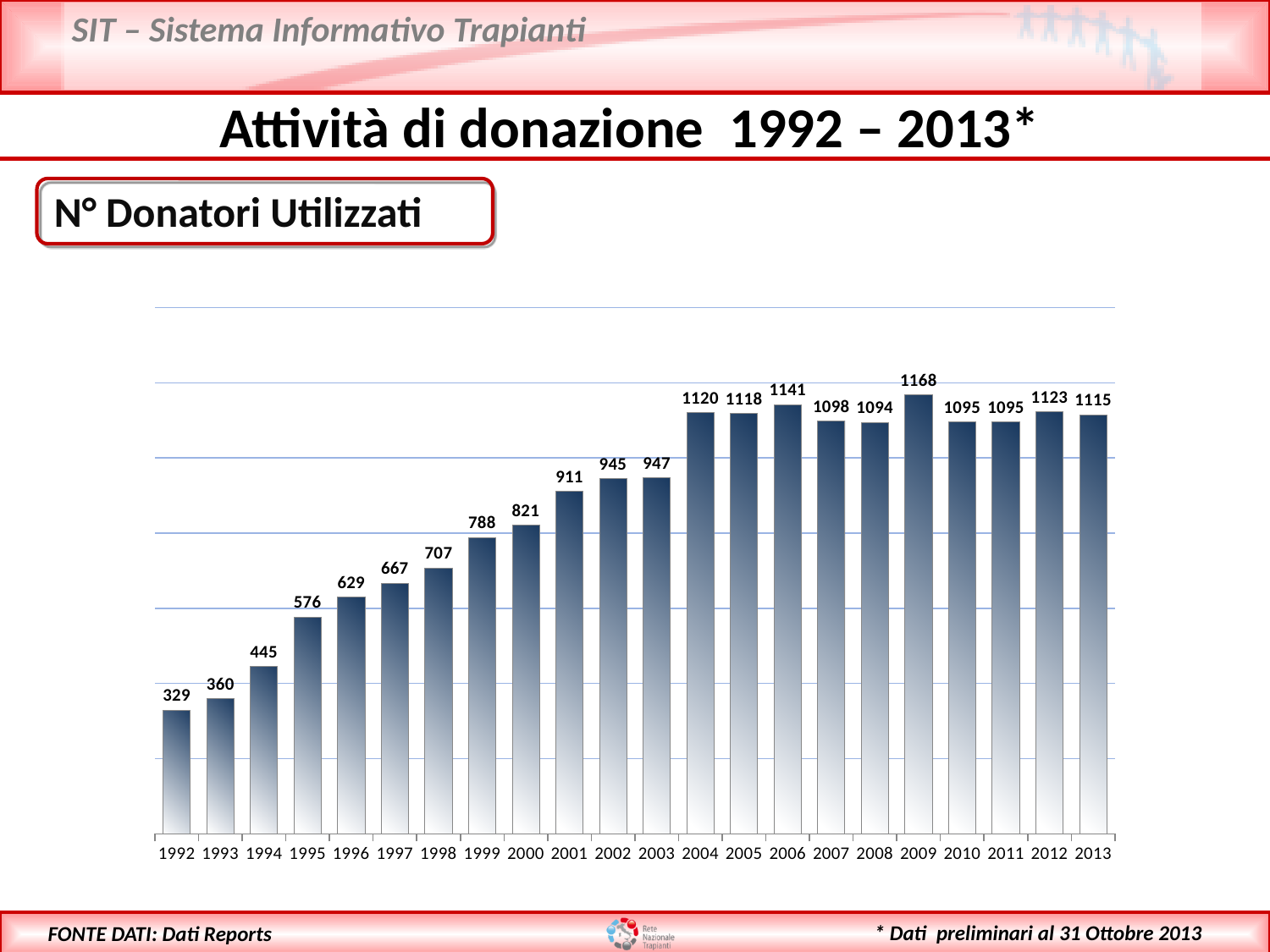
What is the difference between the number of donors used in 2009 and in 1992? 839 What is the difference between the number of donors used in 2004 and in 2003? 173 Which year has the highest number of donors used? 2009 What is the number of donors used in 2009? 1168 Which year has more donors used, 2006 or 2007? 2006 How many years are shown on the x axis of the chart? 22 What kind of chart is shown on the slide? Bar chart What is the number of donors used in 2013? 1115 Do the values generally rise or fall from 1992 to 2004? Rise Which year has the lowest number of donors used? 1992 What is the number of donors used in 1992? 329 What is the label in the box above the chart? N° Donatori Utilizzati